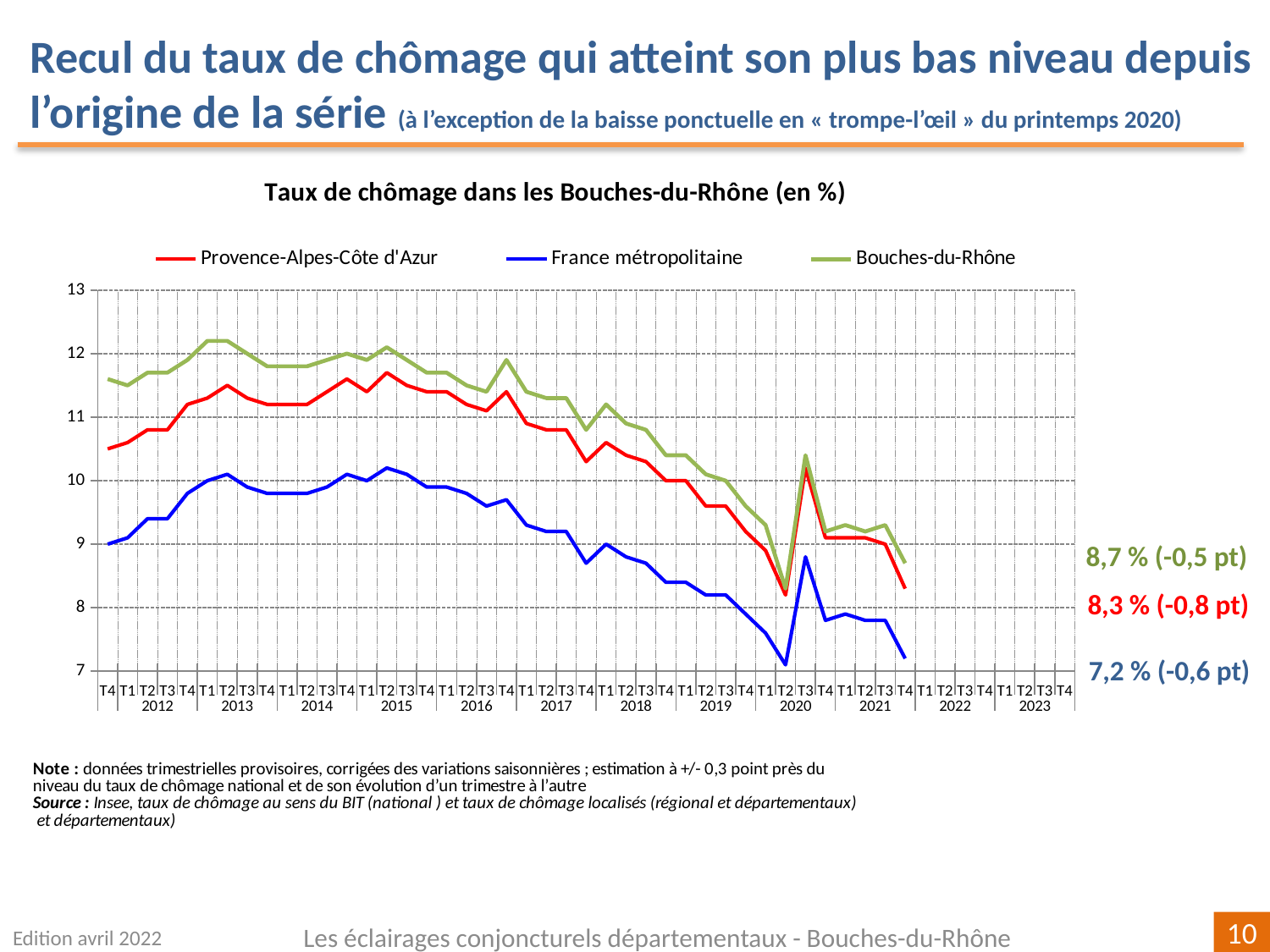
By how many points did the Bouches-du-Rhône rate change according to the annotation? -0,5 pt What is the latest unemployment rate shown for France métropolitaine? 7,2 % Which series has the lowest values across the chart? France métropolitaine Which series has the highest values across the chart? Bouches-du-Rhône Overall, do the unemployment rates rise or fall from 2012 to 2021? Fall What is the latest unemployment rate shown for Bouches-du-Rhône? 8,7 % What kind of chart is shown on the slide? Line chart How many series does the legend list? 3 What is the difference between the latest Bouches-du-Rhône rate and the latest France métropolitaine rate? 1,5 points What is the latest unemployment rate shown for Provence-Alpes-Côte d'Azur? 8,3 % Is the value for France métropolitaine in T2 2020 greater or less than 8? less Is the value for Bouches-du-Rhône in T1 2013 greater or less than 12? greater